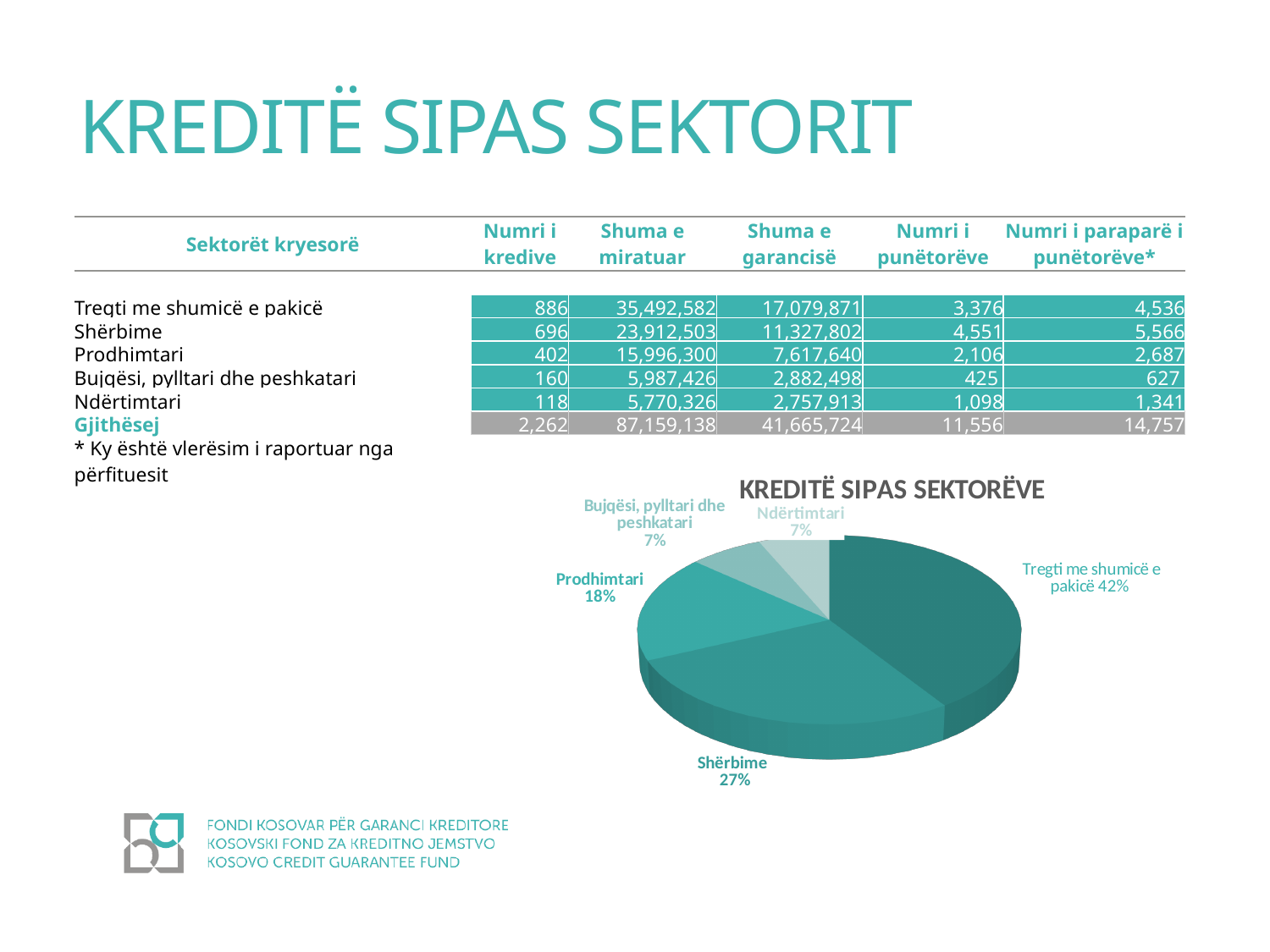
What is the difference in percentage points between the Prodhimtari slice and the Ndërtimtari slice? 11 What share of the pie does Prodhimtari have? 18% How many slices does the pie chart have? 5 Which slice is larger, Shërbime or Prodhimtari? Shërbime What share of the pie does Bujqësi, pylltari dhe peshkatari have? 7% What kind of chart is shown on the slide? pie chart What is the difference in percentage points between the Tregti me shumicë e pakicë slice and the Shërbime slice? 15 What share of the pie does Shërbime have? 27% What is the title of the pie chart? KREDITË SIPAS SEKTORËVE Which sector has the largest slice of the pie? Tregti me shumicë e pakicë